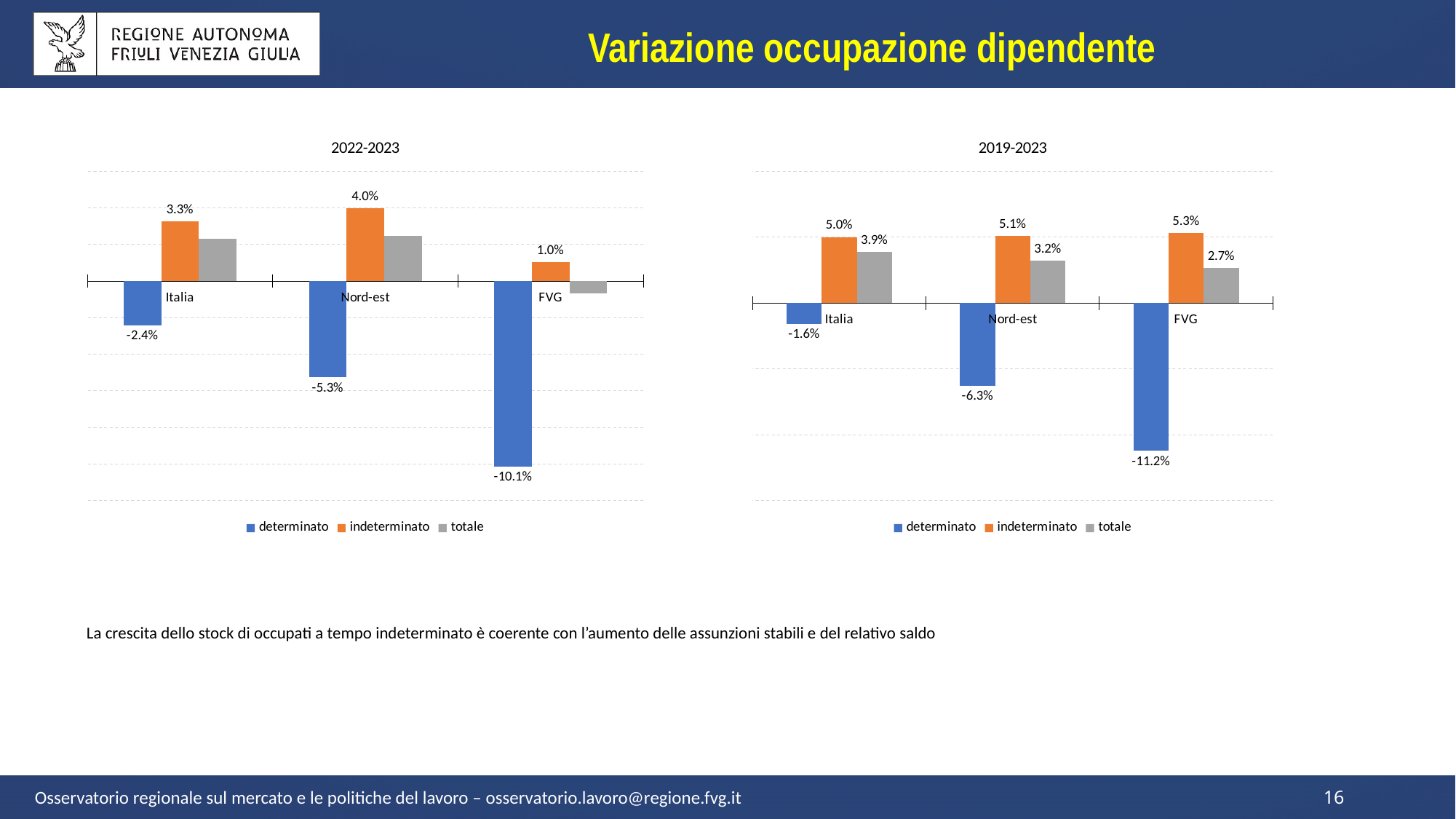
In the 2019-2023 chart, which category has the highest totale value? Italia In the 2022-2023 chart, what is the difference between the indeterminato values for Nord-est and FVG? 3.0% What type of chart is the 2022-2023 chart? Bar chart How many categories are shown in the 2022-2023 chart? 3 In the 2019-2023 chart, what is the value for determinato in Nord-est? -6.3% In the 2019-2023 chart, what is the value for totale in Italia? 3.9% In the 2022-2023 chart, what is the value for indeterminato in Nord-est? 4.0% In the 2019-2023 chart, what is the difference between the totale values for Italia and FVG? 1.2% How many series does the legend of the 2019-2023 chart list? 3 In the 2022-2023 chart, what is the value for determinato in FVG? -10.1% In the 2019-2023 chart, which is larger, the indeterminato value for Italia or for FVG? FVG In the 2022-2023 chart, which category has the lowest determinato value? FVG